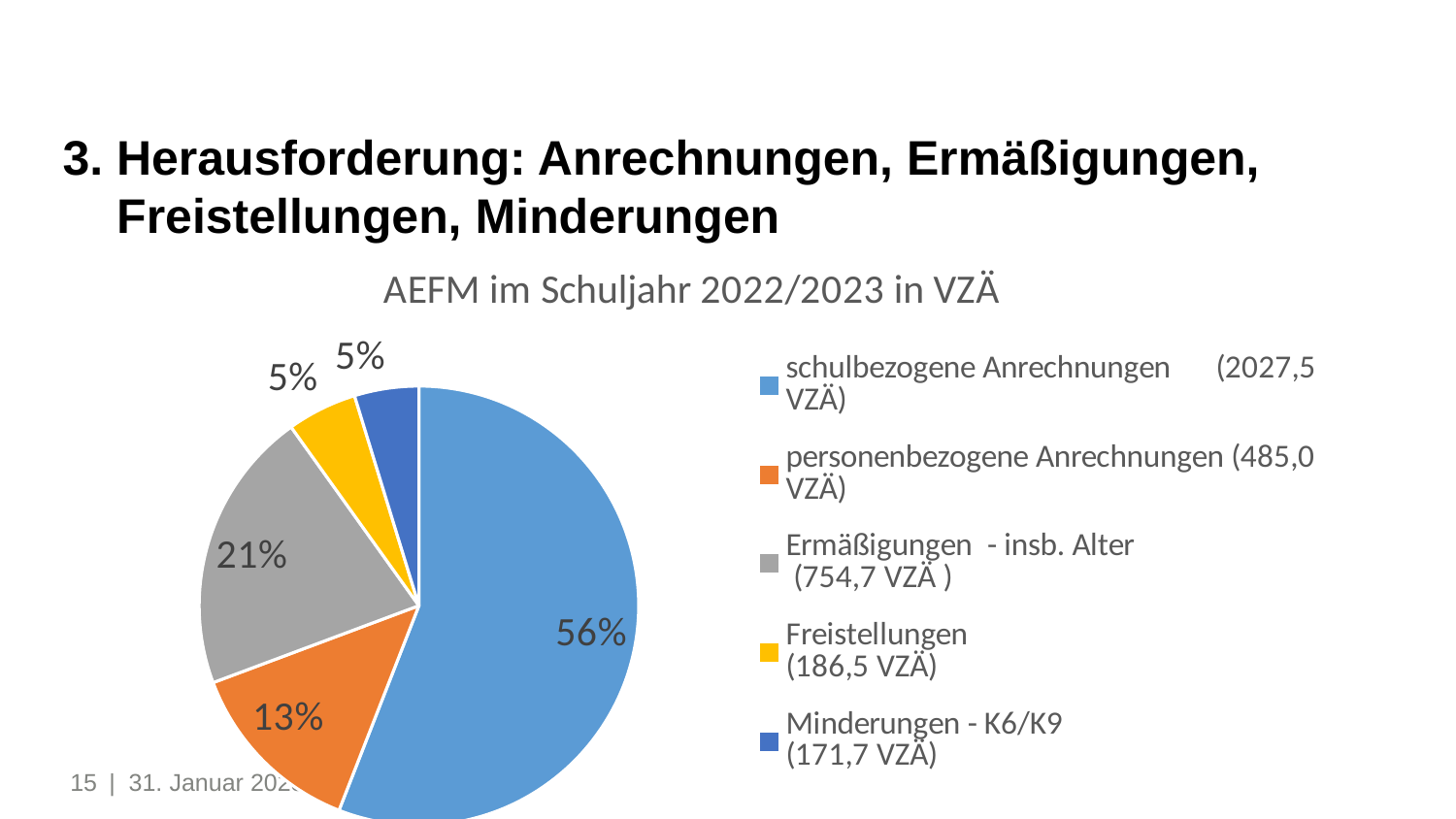
How many slices does the pie chart have? 5 How many entries does the legend list? 5 What kind of chart is shown on the slide? pie chart According to the legend, what is the VZÄ value for Ermäßigungen - insb. Alter? 754,7 VZÄ What is the title of the chart? AEFM im Schuljahr 2022/2023 in VZÄ According to the legend, what is the VZÄ value for Minderungen - K6/K9? 171,7 VZÄ What share of the pie is Ermäßigungen - insb. Alter? 21% What share of the pie is personenbezogene Anrechnungen? 13% What share of the pie is Freistellungen? 5% Which category has the largest slice of the pie? schulbezogene Anrechnungen Which slice is larger: personenbezogene Anrechnungen or Ermäßigungen - insb. Alter? Ermäßigungen - insb. Alter